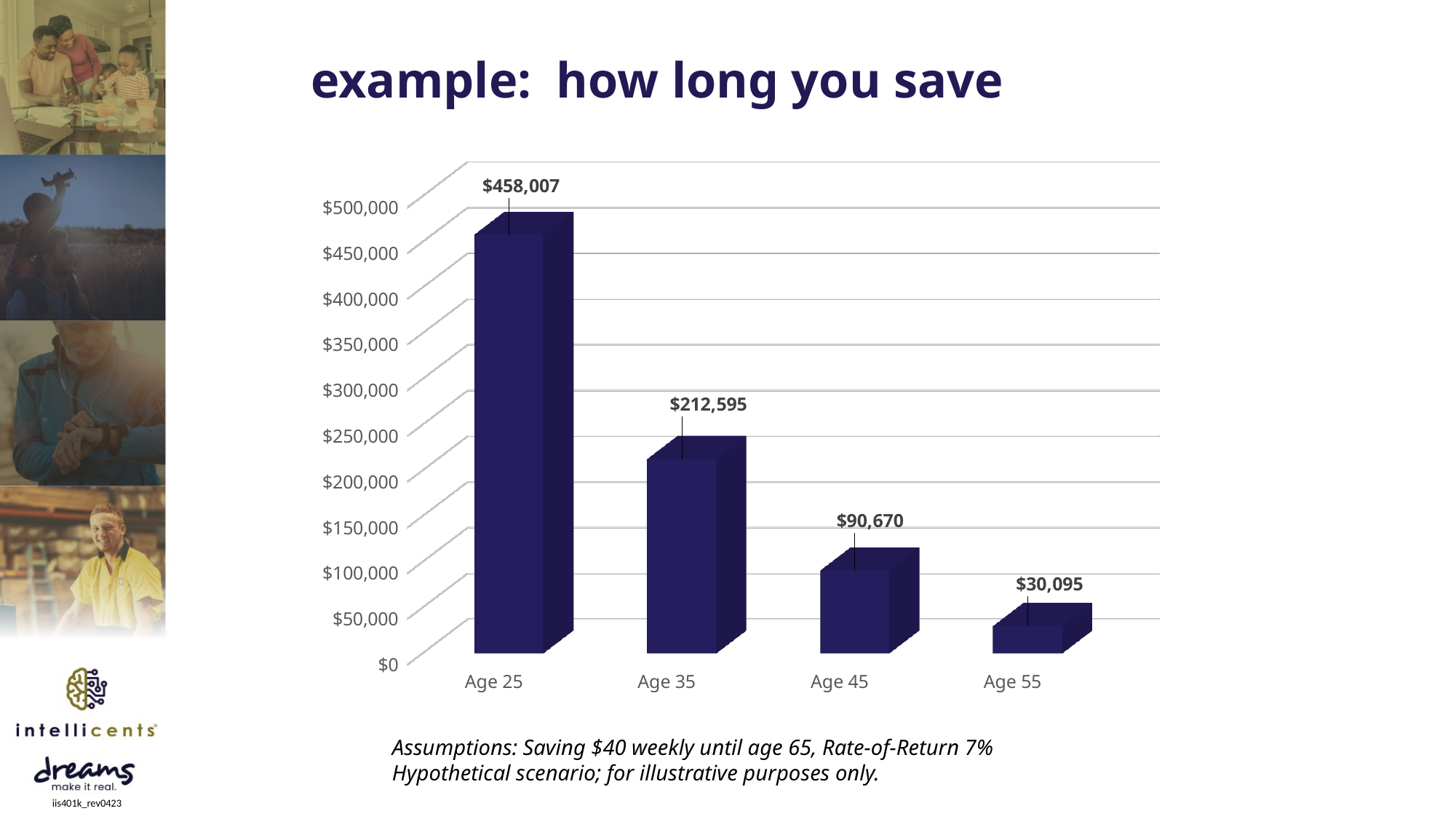
What is the difference between the values for Age 25 and Age 35? $245,412 What is the value for Age 45? $90,670 What is the value for Age 55? $30,095 What is the value for Age 35? $212,595 How many categories are shown on the chart? 4 What kind of chart is shown on the slide? Bar chart Do the values rise or fall from Age 25 to Age 55? Fall Which category has the lowest value? Age 55 Which category has the highest value? Age 25 What is the difference between the values for Age 45 and Age 55? $60,575 What is the value for Age 25? $458,007 Which is larger, the value for Age 35 or the value for Age 45? Age 35